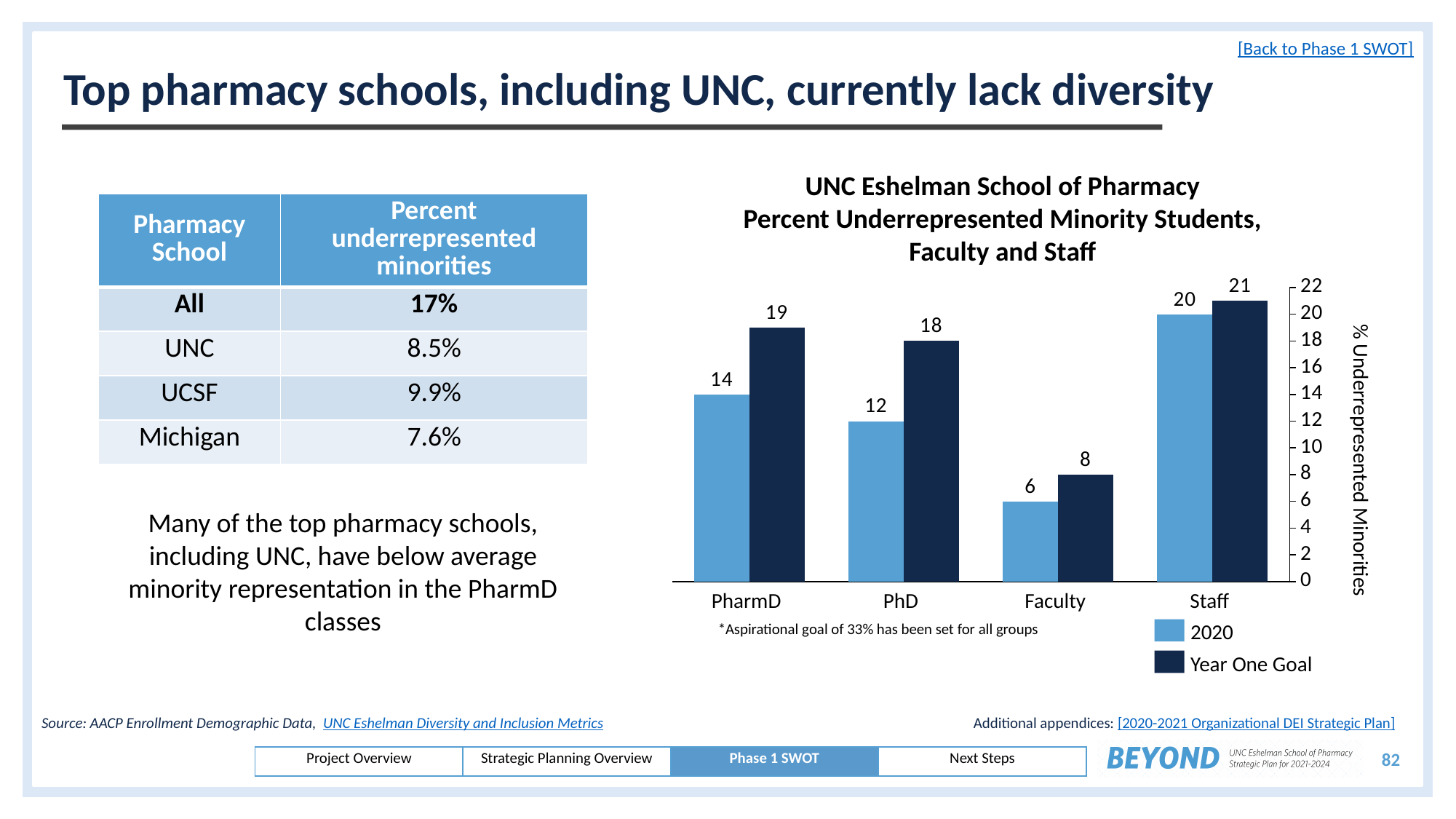
How many series does the chart legend list? 2 What is the 2020 value for Faculty? 6 What kind of chart is shown on the slide? Bar chart What is the Year One Goal value for PhD? 18 Which category has the highest 2020 value? Staff Which category has the lowest Year One Goal value? Faculty What is the Year One Goal value for Staff? 21 How many categories are shown on the x axis of the chart? 4 What is the label of the vertical axis of the chart? % Underrepresented Minorities What is the difference between the Year One Goal and 2020 values for PhD? 6 What is the 2020 value for PharmD? 14 Which is larger, the 2020 value for PharmD or the 2020 value for PhD? PharmD